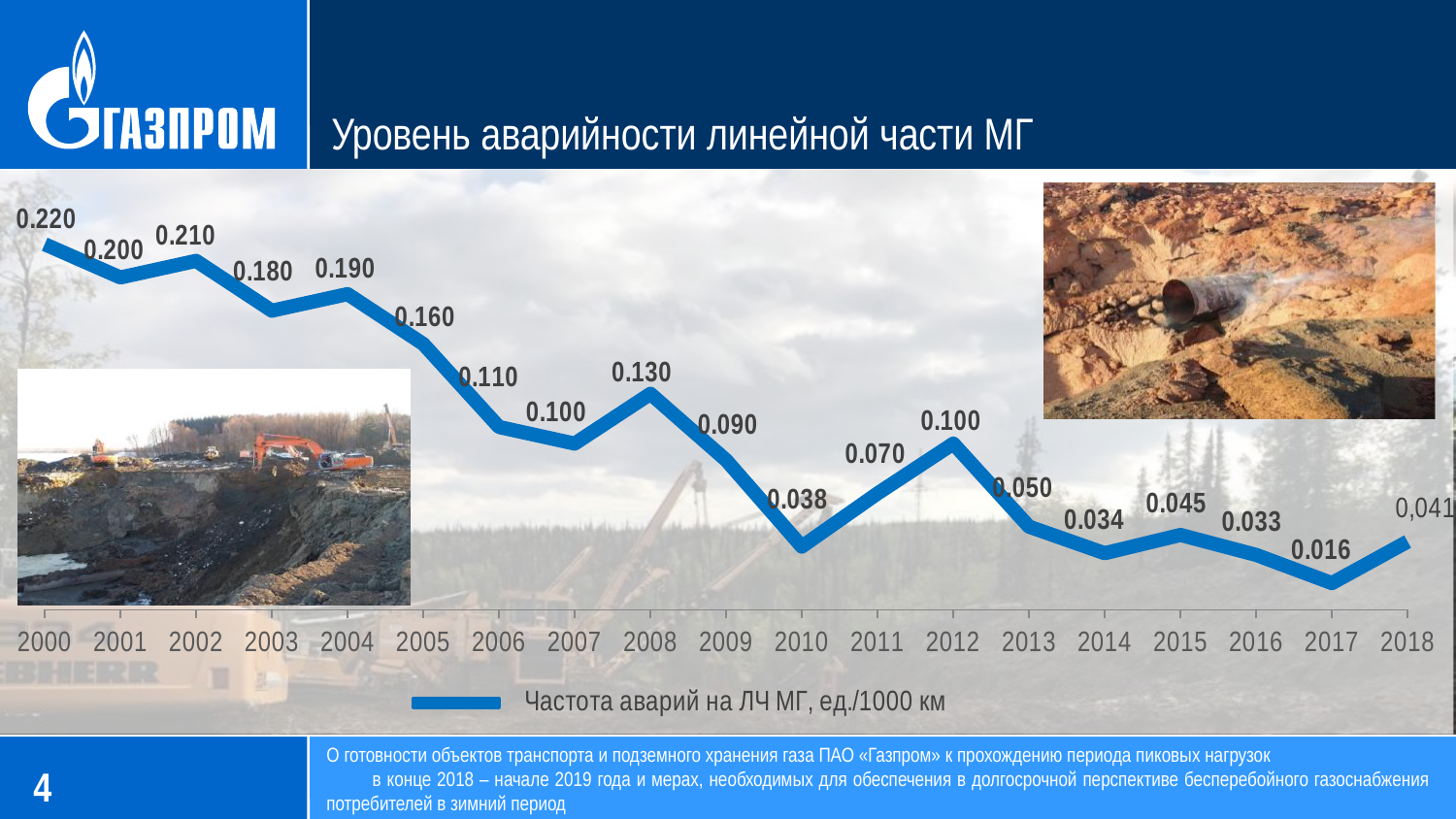
How many years are plotted on the x axis? 19 What type of chart is shown on the slide? line chart What is the accident frequency value for 2018? 0,041 Which year has the highest accident frequency? 2000 What is the difference between the values for 2000 and 2017? 0.204 Which year has the lowest accident frequency? 2017 What is the accident frequency value for 2000? 0.220 Which year has a larger value, 2012 or 2013? 2012 What is the accident frequency value for 2008? 0.130 What is the legend entry for the plotted line? Частота аварий на ЛЧ МГ, ед./1000 км Do the values generally rise or fall from 2000 to 2018? fall What is the accident frequency value for 2010? 0.038